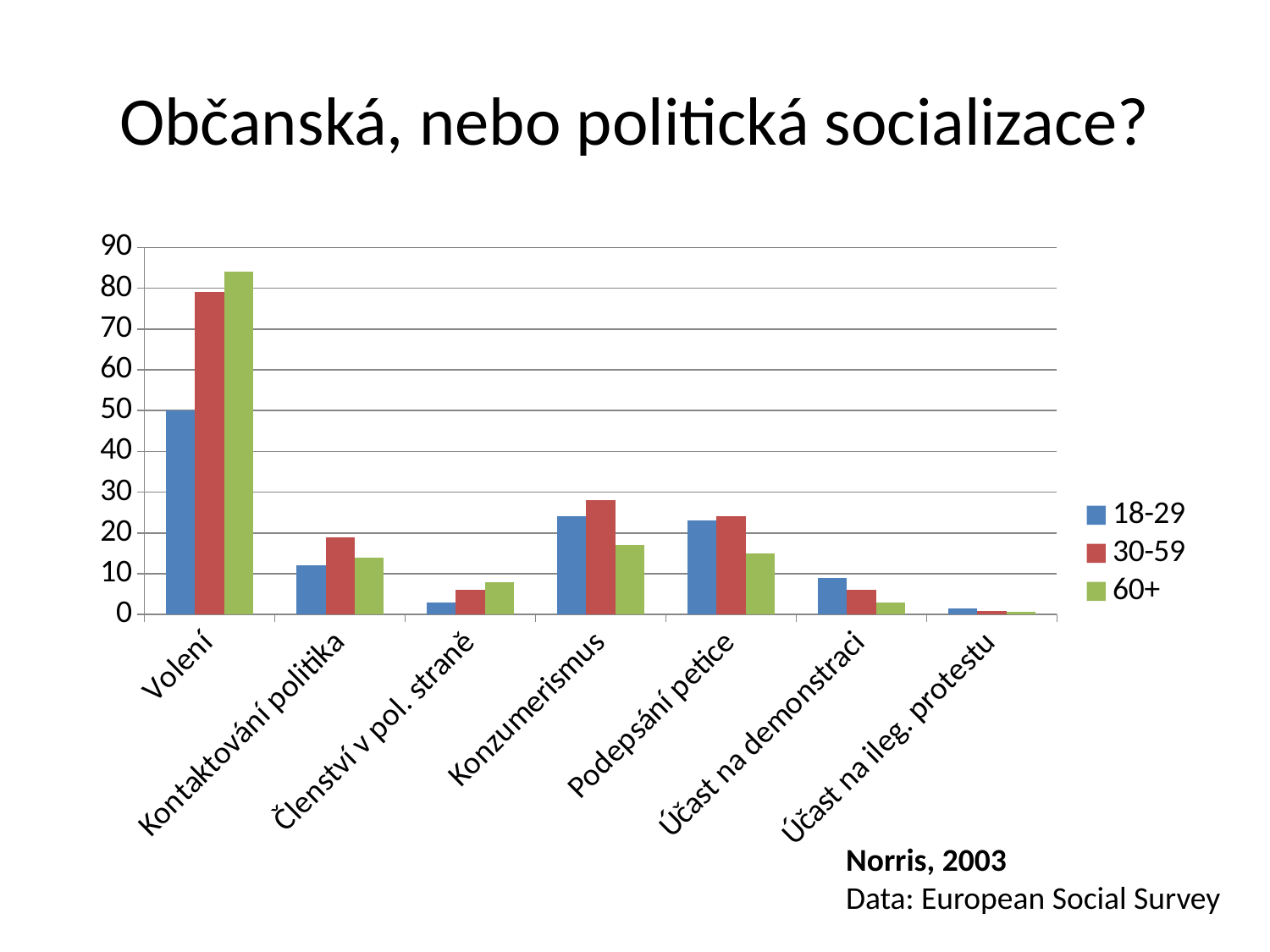
For Účast na demonstraci, which series has the larger value: 18-29 or 60+? 18-29 Is the value for Volení in the 30-59 series greater or less than 70? greater How many series does the legend list? 3 Which category has the lowest value for the 18-29 series? Účast na ileg. protestu Which category has the highest value for the 60+ series? Volení Is the value for Kontaktování politika in the 30-59 series greater or less than 10? greater How many categories are shown on the x axis? 7 What are the three series listed in the legend? 18-29, 30-59, 60+ For Volení, which series has the larger value: 18-29 or 60+? 60+ What kind of chart is shown on the slide? bar chart Is the value for Podepsání petice in the 60+ series greater or less than 20? less